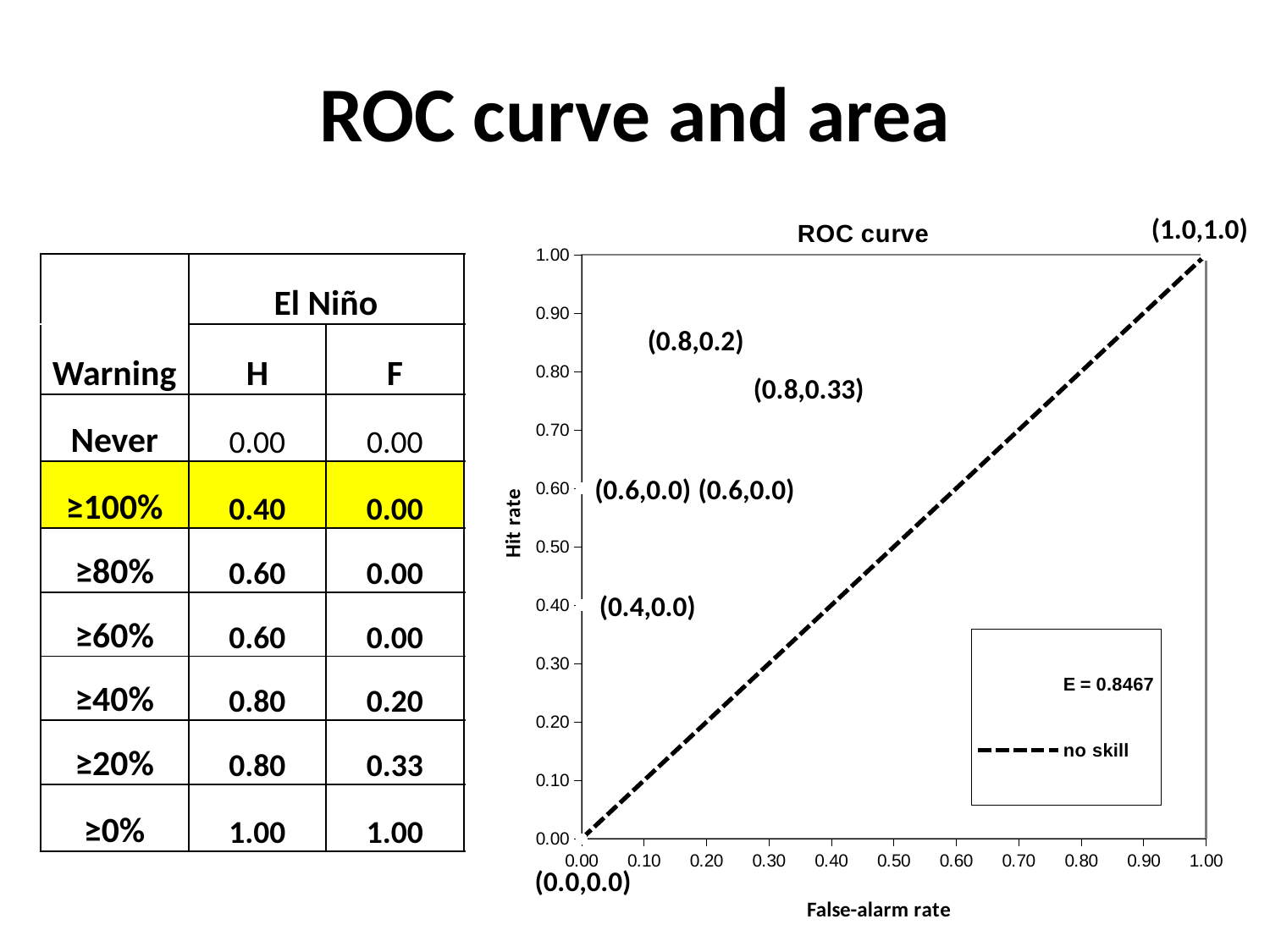
What is the label of the x axis of the ROC curve chart? False-alarm rate What is the title of the chart on the slide? ROC curve Does the no skill line rise or fall as the false-alarm rate increases? rises Is the hit rate of the no skill line at a false-alarm rate of 0.20 greater or less than 0.50? less How many entries does the legend of the ROC curve chart list? 2 What value of E is shown in the legend of the ROC curve chart? E = 0.8467 What kind of chart is the ROC curve chart? line chart What is the highest value shown on the y axis of the ROC curve chart? 1.00 What hit rate does the no skill line have at a false-alarm rate of 0.00? 0.00 How many tick labels are shown on the x axis of the ROC curve chart? 11 Is the hit rate of the no skill line at a false-alarm rate of 0.80 greater or less than 0.50? greater What hit rate does the no skill line reach at a false-alarm rate of 1.00? 1.00